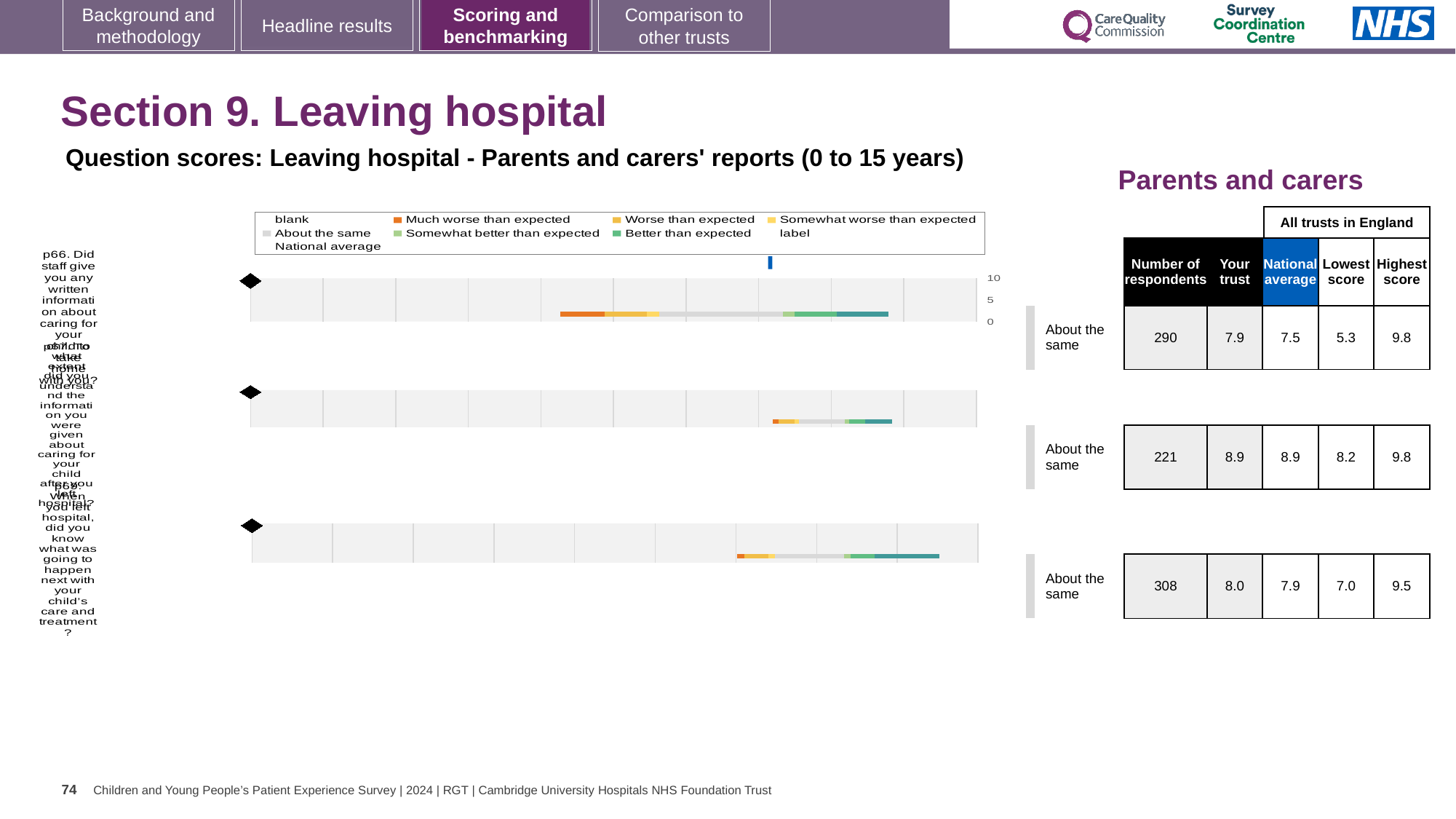
In the Parents and carers table, what is the 'Your trust' score for the top row? 7.9 In the Parents and carers table, what is the lowest score for the top row? 5.3 In the Parents and carers table, what is the national average for the middle row? 8.9 For the top row of the Parents and carers table, what is the difference between the 'Your trust' score and the national average? 0.4 What kind of chart is used for the question scores on this slide? bar chart For the top row of the Parents and carers table, which is larger: the 'Your trust' score or the national average? Your trust In the Parents and carers table, what is the number of respondents for the top row? 290 In the Parents and carers table, what is the highest score for the bottom row? 9.5 Which row of the Parents and carers table has the highest number of respondents? the bottom row (308) In the chart legend, what colour represents 'Much worse than expected'? orange How many question-score bar charts are shown on the slide? 3 What benchmark category is shown next to each of the three question-score charts? About the same